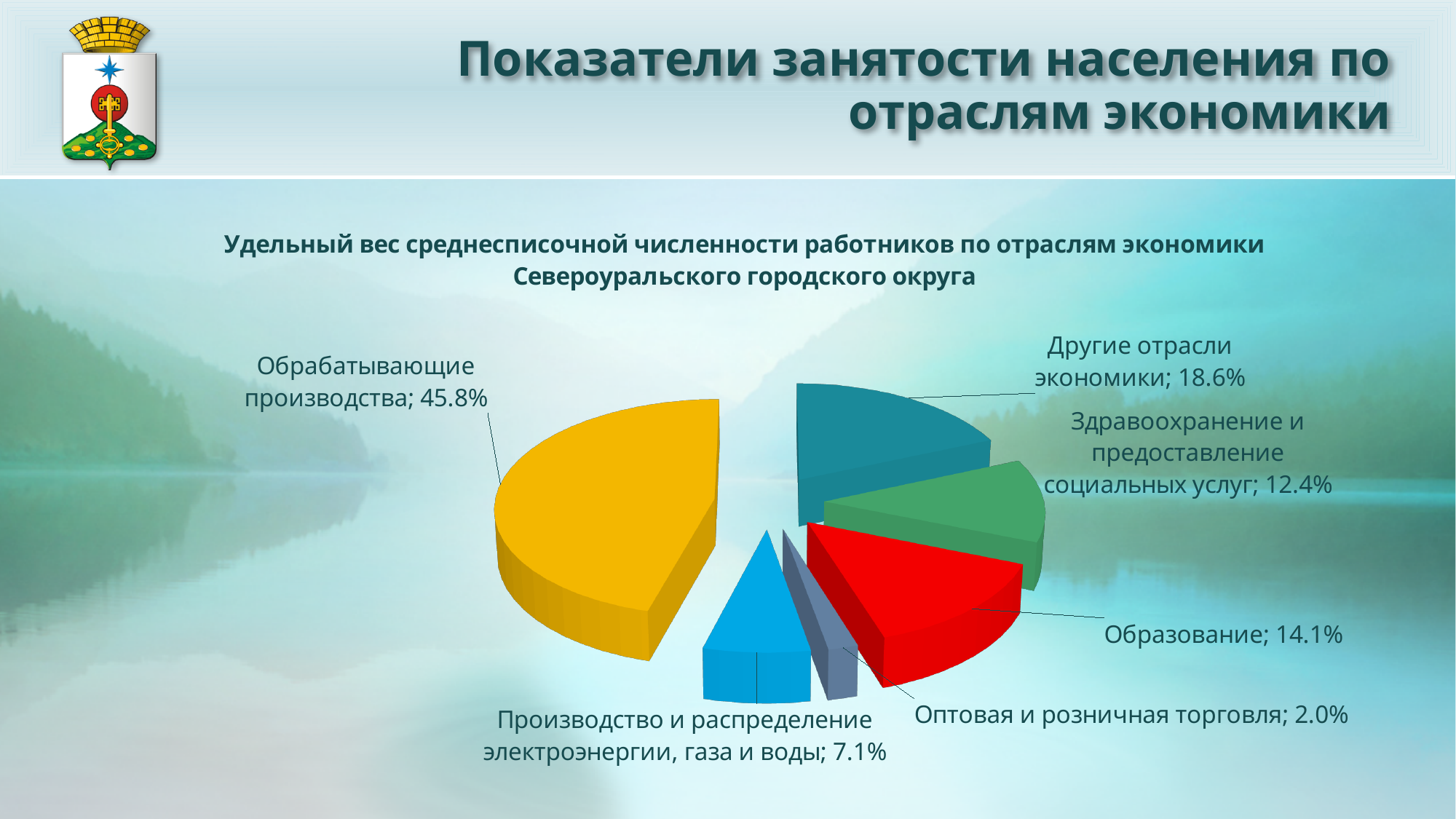
What is the difference between the shares of Другие отрасли экономики and Образование? 4.5% What share does Обрабатывающие производства have in the pie chart? 45.8% How many sectors are shown in the pie chart? 6 What share does Производство и распределение электроэнергии, газа и воды have in the pie chart? 7.1% Which has a larger share: Здравоохранение и предоставление социальных услуг or Образование? Образование What type of chart is shown on the slide? Pie chart Which sector has the largest share in the pie chart? Обрабатывающие производства What share does Оптовая и розничная торговля have in the pie chart? 2.0% What share does Здравоохранение и предоставление социальных услуг have in the pie chart? 12.4% What colour is the slice for Обрабатывающие производства? Yellow What share does Образование have in the pie chart? 14.1% Which sector has the smallest share in the pie chart? Оптовая и розничная торговля